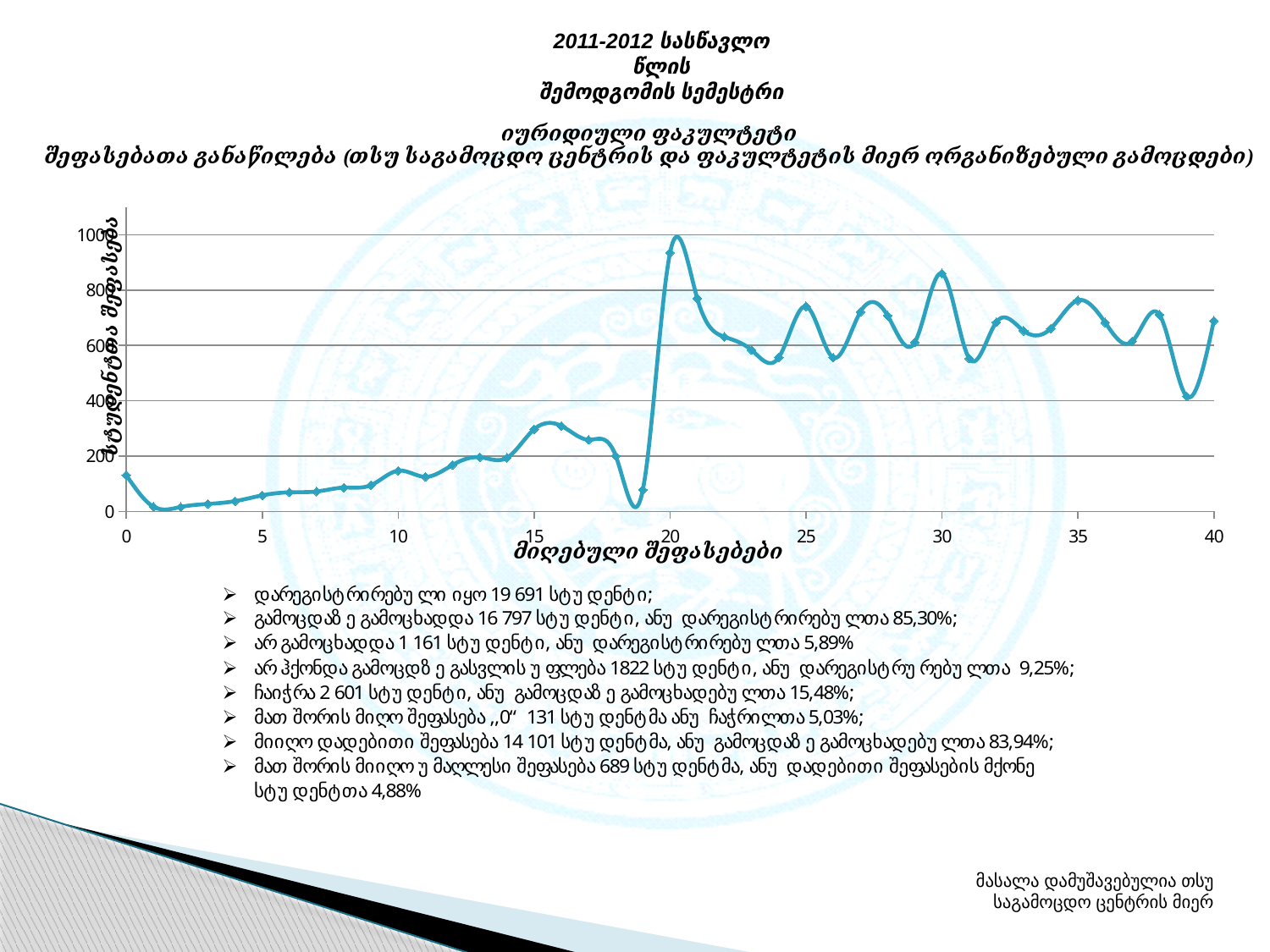
Which has the larger value, x = 10 or x = 15? 15 What is the title of the x axis? მიღებული შეფასებები What kind of chart is shown on the slide? line chart At which x-axis value (grade) does the line reach its highest point? 20 Is the value at x = 25 greater or less than 600? greater Is the value at x = 5 greater or less than 200? less Is the value at x = 20 greater or less than 800? greater Does the line rise or fall between x = 19 and x = 20? rise Which has the larger value, x = 20 or x = 30? 20 What colour is the plotted line? blue